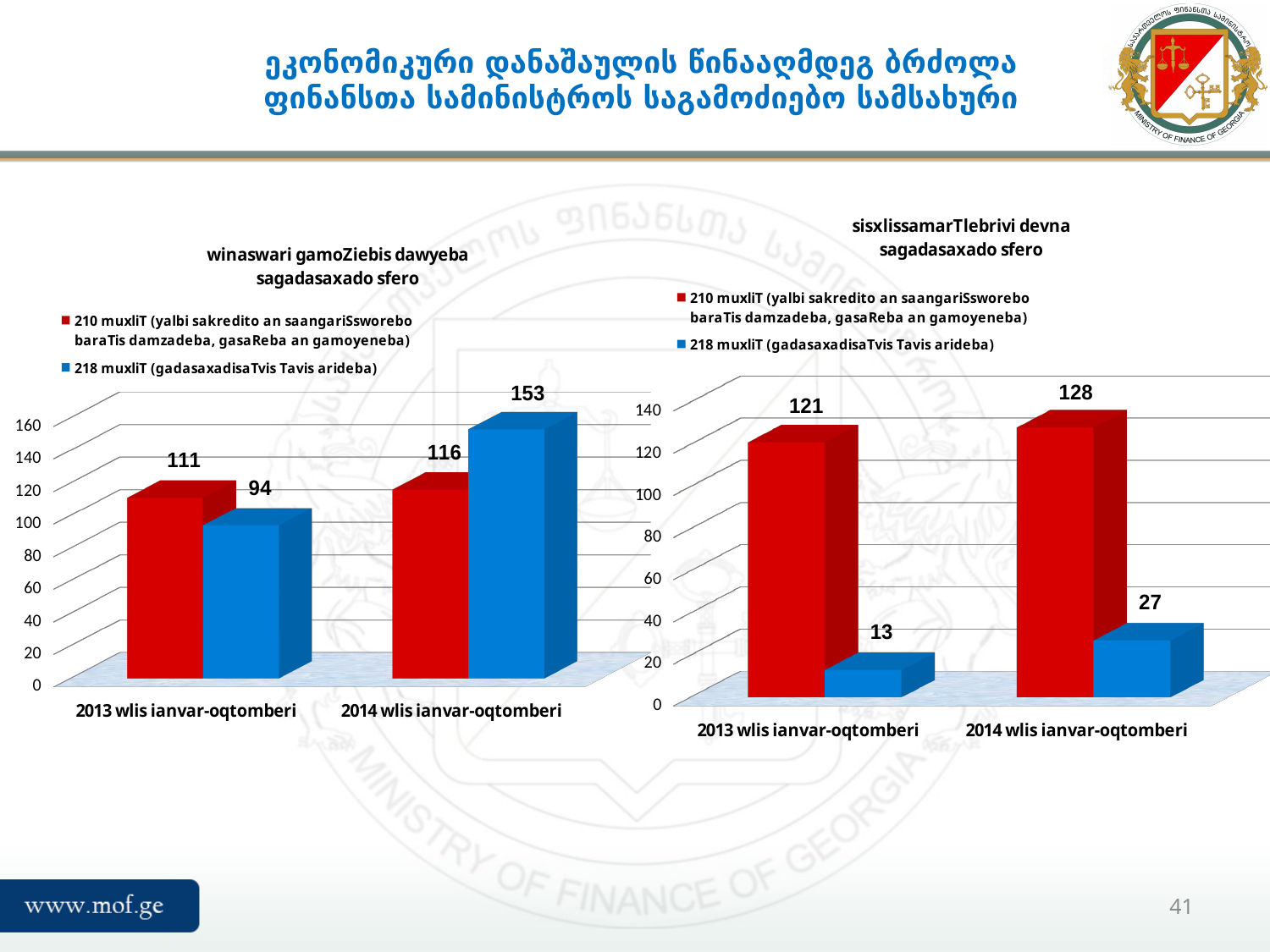
In the right chart (sisxlissamarTlebrivi devna sagadasaxado sfero), what is the value for 210 muxliT in 2014 wlis ianvar-oqtomberi? 128 What kind of chart is the left chart (winaswari gamoZiebis dawyeba sagadasaxado sfero)? Bar chart In the left chart (winaswari gamoZiebis dawyeba sagadasaxado sfero), what is the value for 210 muxliT in 2013 wlis ianvar-oqtomberi? 111 In the right chart (sisxlissamarTlebrivi devna sagadasaxado sfero), does the 218 muxliT value rise or fall from 2013 to 2014? Rise In the right chart (sisxlissamarTlebrivi devna sagadasaxado sfero), which bar has the lowest value? 218 muxliT, 2013 wlis ianvar-oqtomberi In the left chart (winaswari gamoZiebis dawyeba sagadasaxado sfero), what is the value for 218 muxliT in 2014 wlis ianvar-oqtomberi? 153 In the right chart (sisxlissamarTlebrivi devna sagadasaxado sfero), what is the value for 218 muxliT in 2013 wlis ianvar-oqtomberi? 13 In the left chart (winaswari gamoZiebis dawyeba sagadasaxado sfero), what is the difference between the 218 muxliT values for 2014 and 2013? 59 In the left chart (winaswari gamoZiebis dawyeba sagadasaxado sfero), which is larger in 2013 wlis ianvar-oqtomberi: 210 muxliT or 218 muxliT? 210 muxliT How many series does the legend of the right chart (sisxlissamarTlebrivi devna sagadasaxado sfero) list? 2 In the right chart (sisxlissamarTlebrivi devna sagadasaxado sfero), what is the difference between the 210 muxliT and 218 muxliT values in 2014 wlis ianvar-oqtomberi? 101 In the left chart (winaswari gamoZiebis dawyeba sagadasaxado sfero), which bar has the highest value? 218 muxliT, 2014 wlis ianvar-oqtomberi